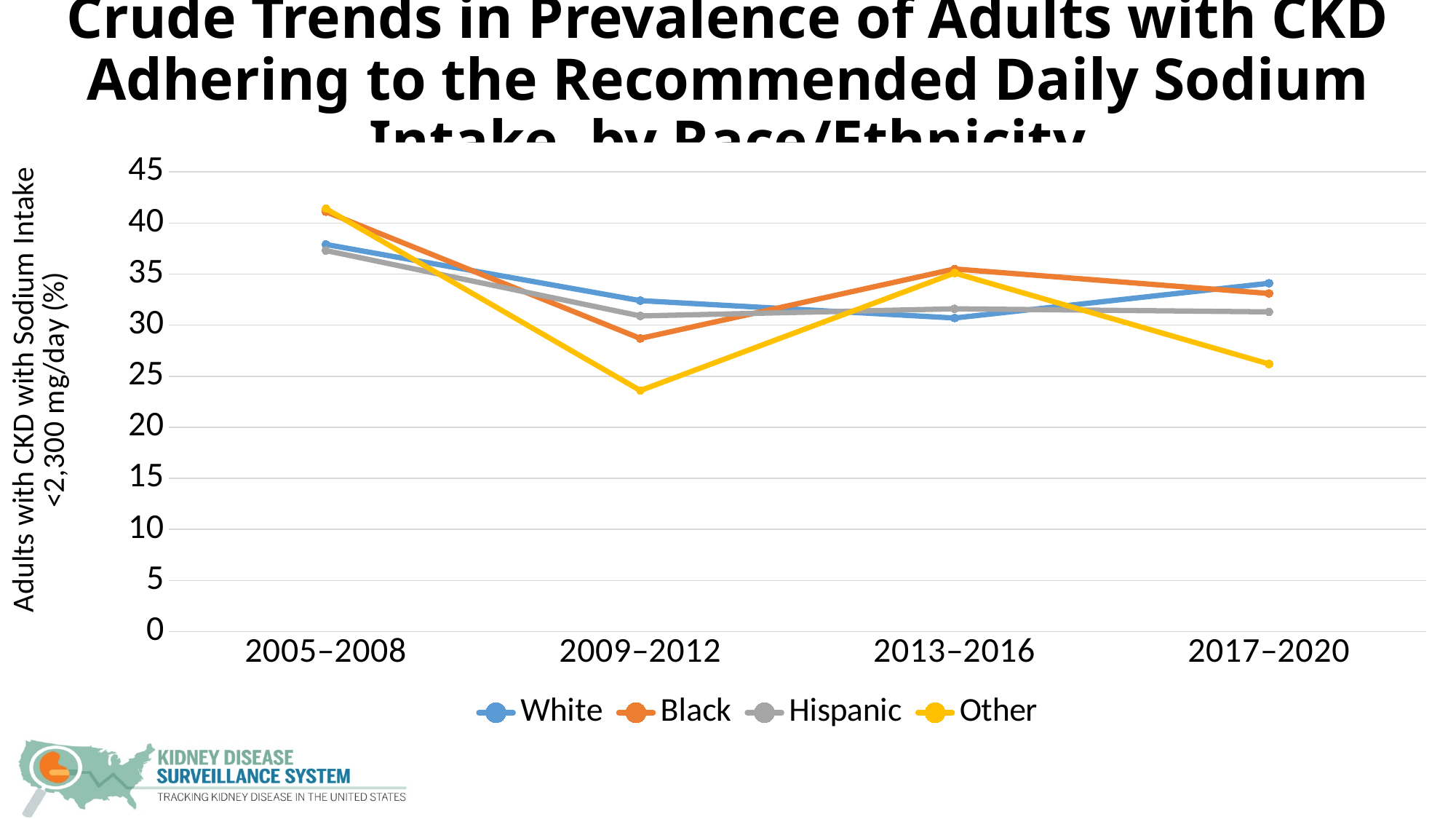
Is the value for Other in 2009–2012 greater or less than 25? less Which series does the yellow line represent? Other In which period is the value for Black highest? 2005–2008 Is the value for Black in 2009–2012 greater or less than 30? less Which series has the lowest value in 2017–2020? Other Is the value for Other in 2017–2020 greater or less than 30? less In 2009–2012, which is larger, the value for Black or the value for Other? Black How many time periods are shown on the x axis? 4 In which period is the value for Other lowest? 2009–2012 What kind of chart is shown on the slide? line chart How many series does the legend list? 4